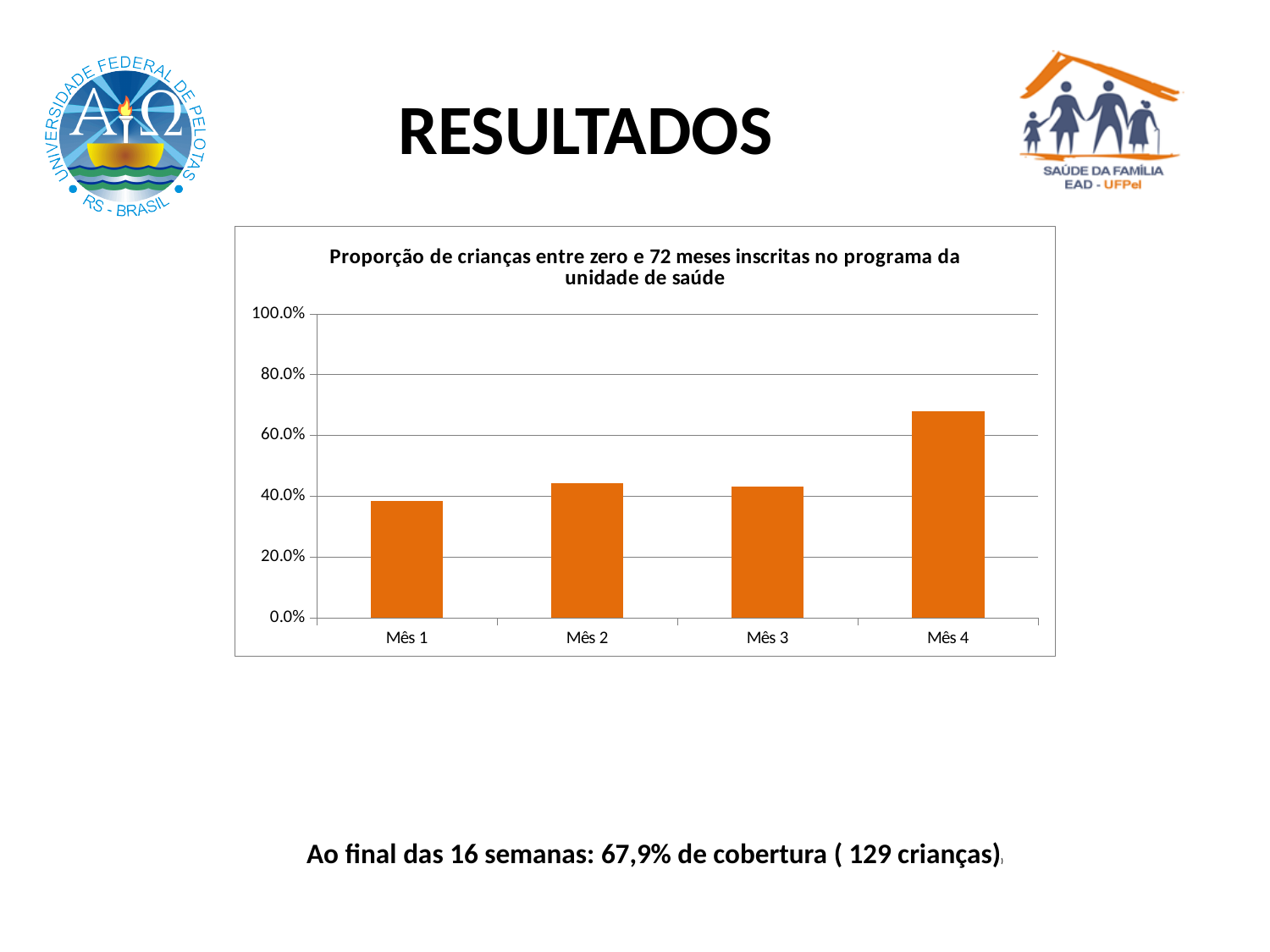
How many categories (months) are plotted on the chart? 4 Is the value for Mês 2 greater or less than 40.0%? greater Is the value for Mês 4 greater or less than 80.0%? less What is the maximum value shown on the chart's vertical axis? 100.0% What is the title of the chart? Proporção de crianças entre zero e 72 meses inscritas no programa da unidade de saúde Which month has the lowest proportion of children enrolled? Mês 1 Is the value for Mês 1 greater or less than 40.0%? less Which is larger, the value for Mês 1 or the value for Mês 4? Mês 4 Which is larger, the value for Mês 3 or the value for Mês 4? Mês 4 Which month has the highest proportion of children enrolled? Mês 4 What kind of chart is shown on the slide? bar chart